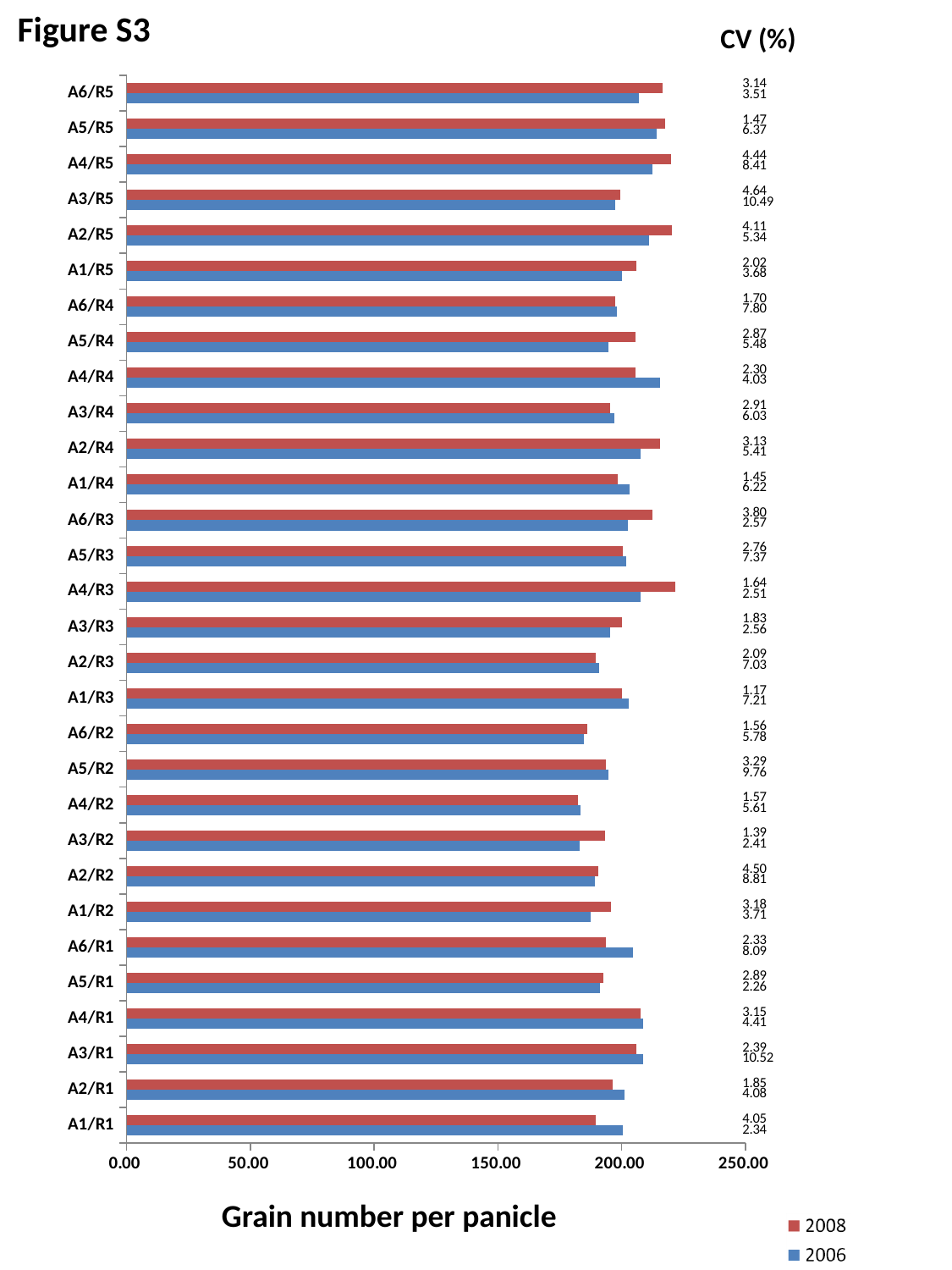
For A4/R3, which series has the larger value, 2008 or 2006? 2008 What type of chart is shown on the slide? bar chart What are the two CV (%) values printed next to A3/R5? 4.64 and 10.49 For A6/R1, which series has the larger value, 2008 or 2006? 2006 Is the 2008 value for A4/R3 greater or less than 200? greater What is the title of the horizontal axis? Grain number per panicle Is the 2006 value for A6/R2 greater or less than 200? less How many categories are plotted on the vertical axis? 30 Is the 2008 value for A4/R2 greater or less than 200? less Which years are listed in the legend? 2008 and 2006 How many series does the legend list? 2